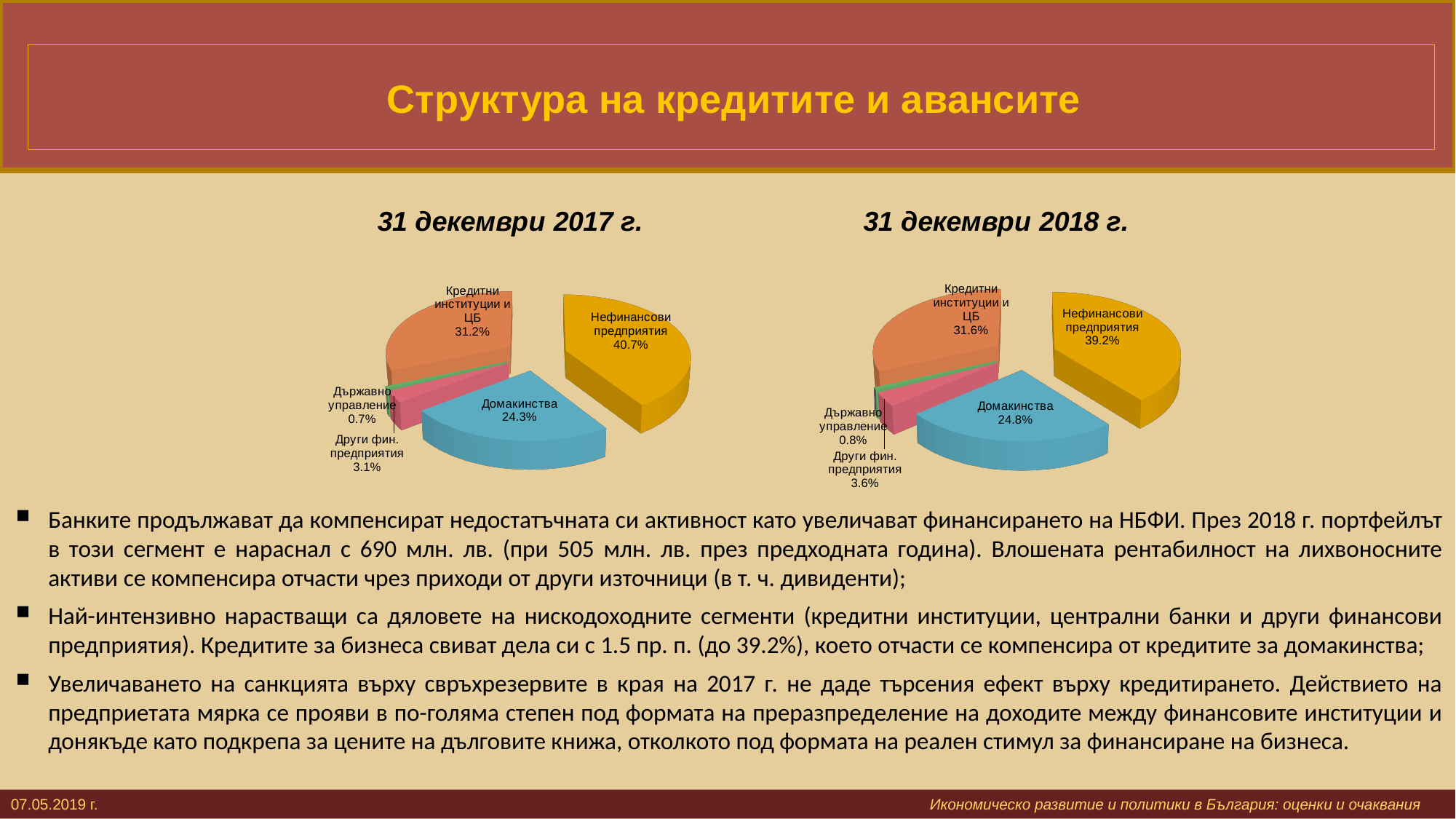
In the "31 декември 2018 г." chart, what share is shown for Домакинства? 24.8% In the "31 декември 2018 г." chart, what is the difference between the shares of Кредитни институции и ЦБ and Домакинства? 6.8 percentage points In the "31 декември 2018 г." chart, which category has the smallest slice? Държавно управление In the "31 декември 2017 г." chart, what share is shown for Държавно управление? 0.7% What is the title of the slide containing the two charts? Структура на кредитите и авансите Is the share of Други фин. предприятия larger in the "31 декември 2017 г." chart or in the "31 декември 2018 г." chart? 31 декември 2018 г. In the "31 декември 2017 г." chart, which category has the largest slice? Нефинансови предприятия What type of chart is the "31 декември 2018 г." chart? Pie chart What is the difference between the share of Нефинансови предприятия in the "31 декември 2017 г." chart and in the "31 декември 2018 г." chart? 1.5 percentage points In the "31 декември 2017 г." chart, what share is shown for Нефинансови предприятия? 40.7% In the "31 декември 2018 г." chart, what share is shown for Кредитни институции и ЦБ? 31.6% How many categories are shown in the "31 декември 2017 г." chart? 5